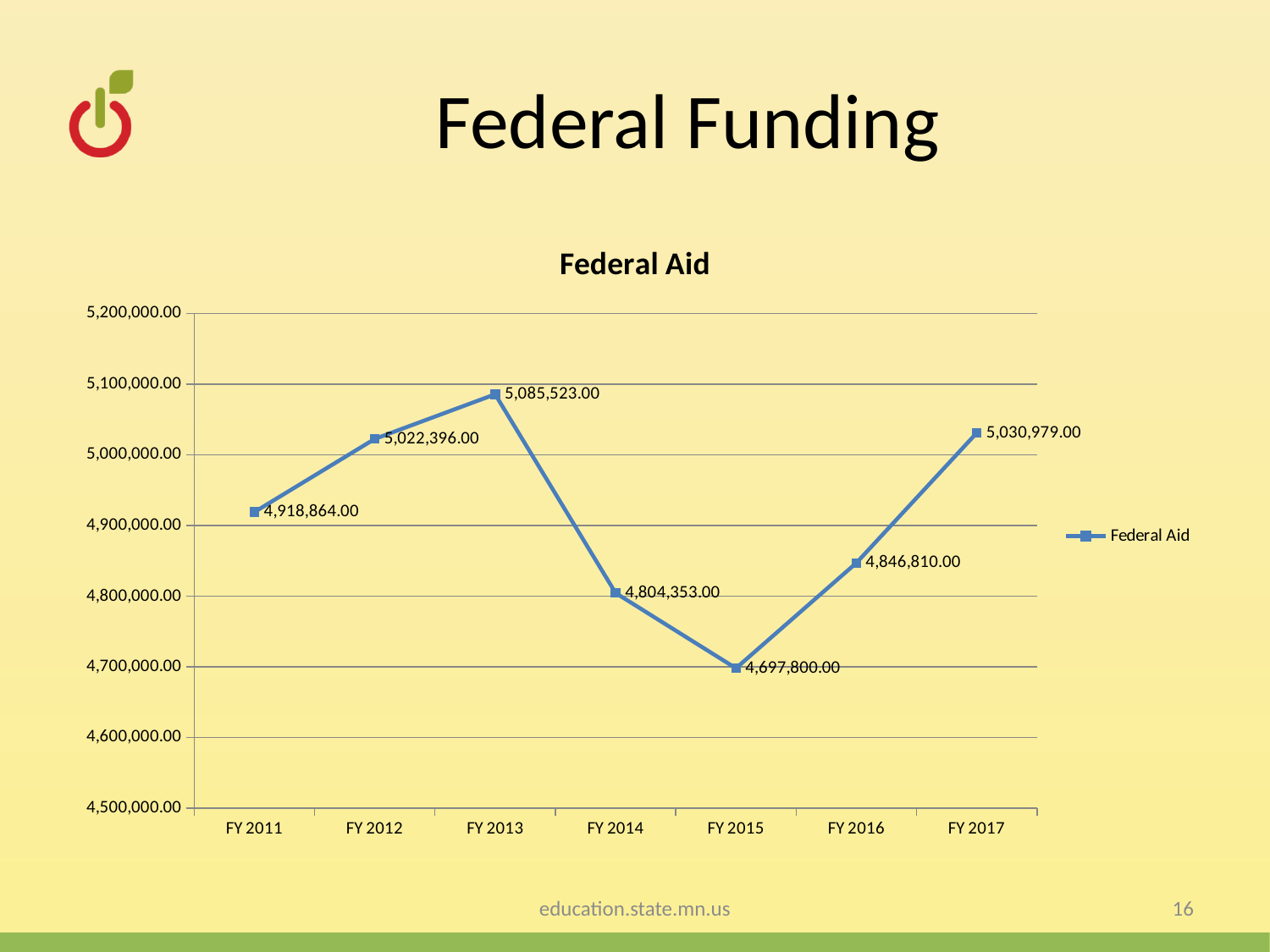
What kind of chart is used to show Federal Aid? line chart What is the difference between the Federal Aid values for FY 2013 and FY 2015? 387,723.00 What is the Federal Aid value for FY 2017? 5,030,979.00 Which fiscal year has the lowest Federal Aid value? FY 2015 Is the Federal Aid value for FY 2014 greater or less than 4,900,000.00? less What is the Federal Aid value for FY 2013? 5,085,523.00 What is the difference between the Federal Aid values for FY 2017 and FY 2016? 184,169.00 Does the Federal Aid value rise or fall from FY 2013 to FY 2015? fall How many fiscal years are plotted on the Federal Aid chart? 7 Which is larger, the Federal Aid value for FY 2012 or for FY 2017? FY 2017 What is the Federal Aid value for FY 2015? 4,697,800.00 Which fiscal year has the highest Federal Aid value? FY 2013